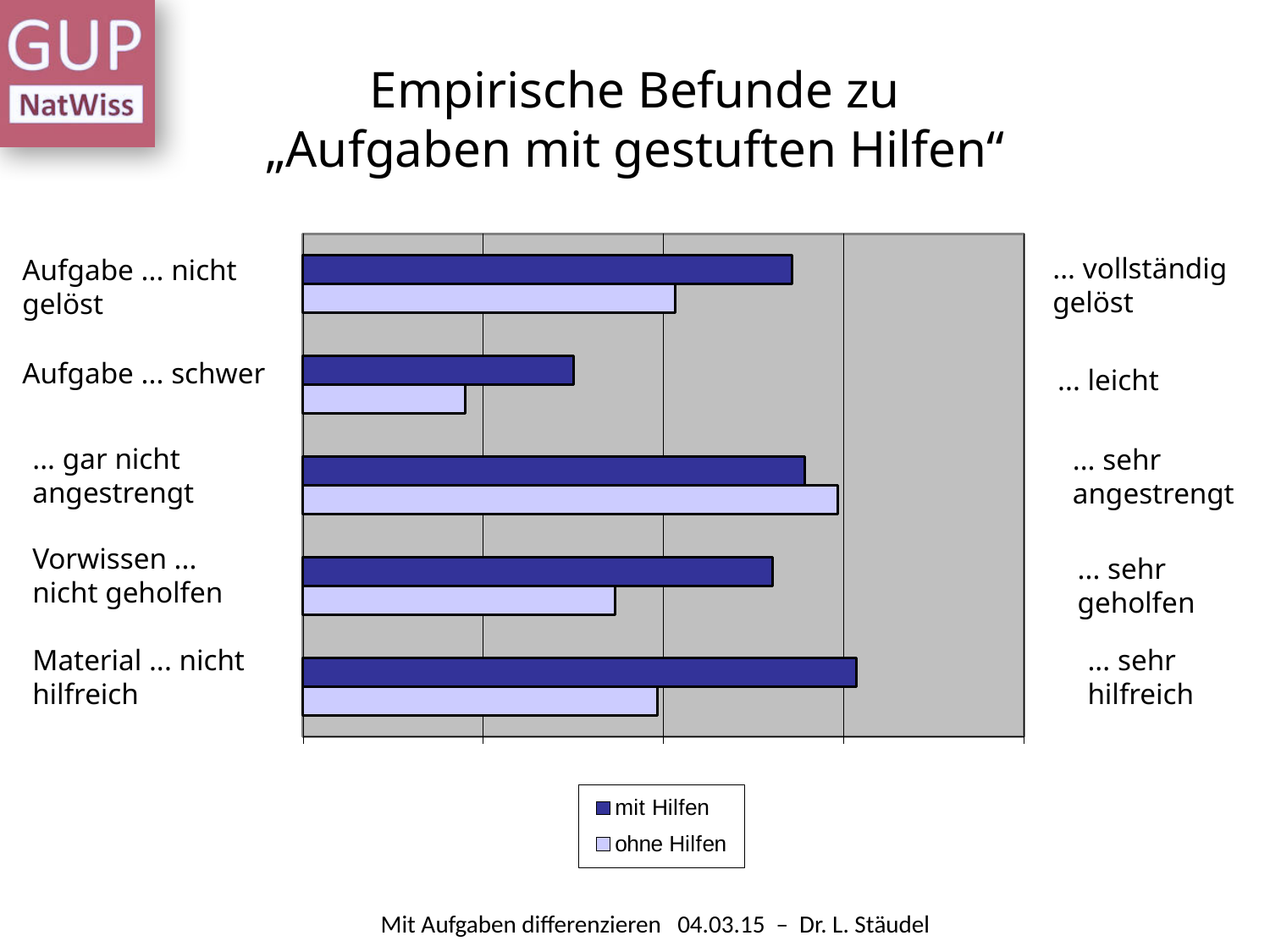
Which series is drawn in dark blue? mit Hilfen For the category "Vorwissen ... nicht geholfen", which series has the longer bar, mit Hilfen or ohne Hilfen? mit Hilfen For the category "Aufgabe ... nicht gelöst", which series has the longer bar, mit Hilfen or ohne Hilfen? mit Hilfen What are the two series named in the legend? mit Hilfen, ohne Hilfen For the category "Material ... nicht hilfreich", which series has the longer bar, mit Hilfen or ohne Hilfen? mit Hilfen Which category has the longest bar for the series mit Hilfen? Material ... nicht hilfreich Which category has the shortest bar for the series mit Hilfen? Aufgabe ... schwer Which category has the longest bar for the series ohne Hilfen? ... gar nicht angestrengt How many series does the legend list? 2 How many categories (pairs of bars) are plotted in the chart? 5 What kind of chart is shown on the slide? bar chart